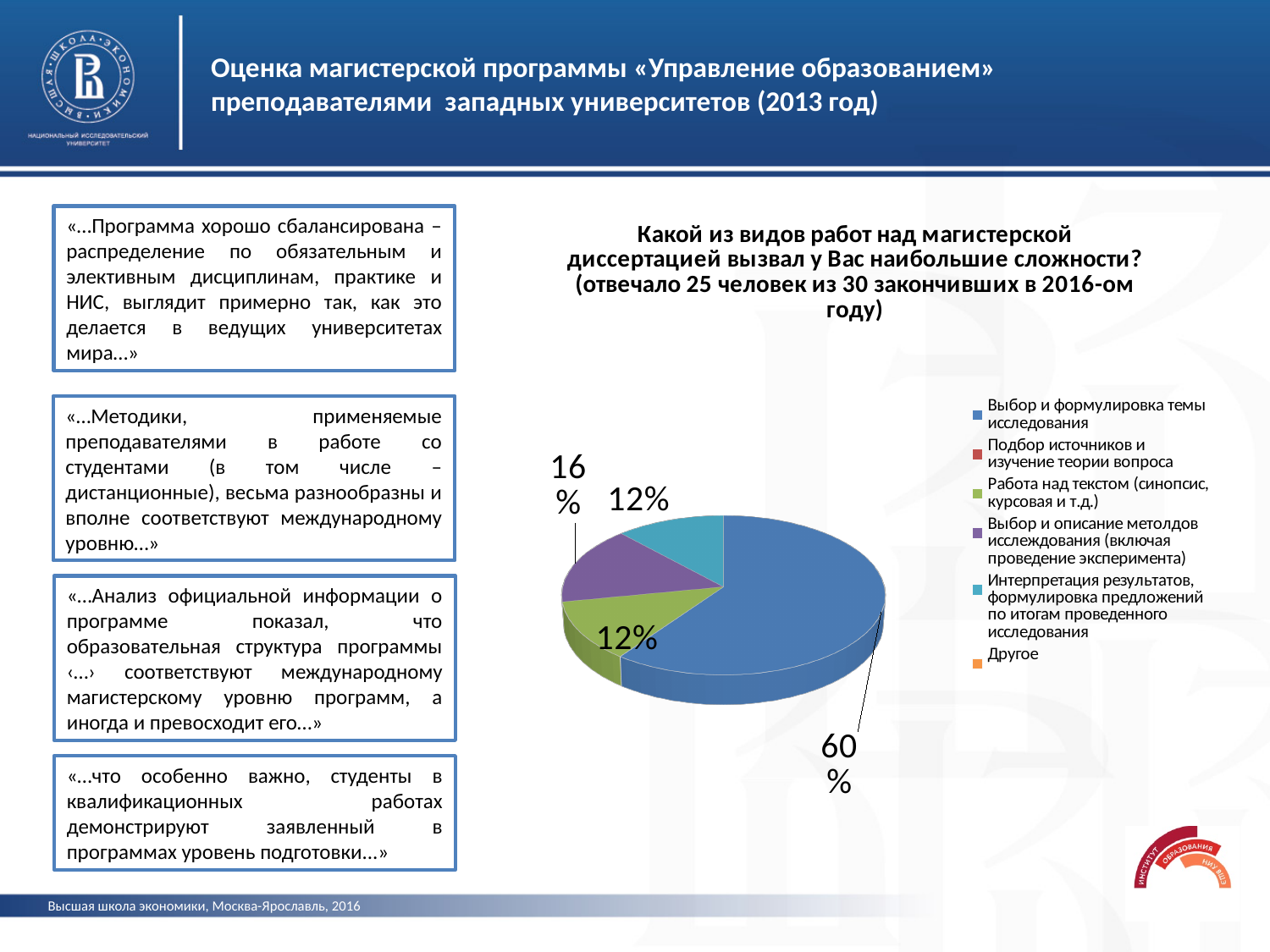
What percentage is shown for "Работа над текстом (синопсис, курсовая и т.д.)"? 12% Which category has the largest share of the pie? Выбор и формулировка темы исследования How many percentage points larger is the share for "Выбор и формулировка темы исследования" than the share for "Выбор и описание методов исследования"? 44 What colour is the slice representing "Выбор и формулировка темы исследования"? blue What percentage is shown for "Выбор и описание методов исследования (включая проведение эксперимента)"? 16% How many entries does the chart legend list? 6 What kind of chart is shown on the slide? pie chart What percentage of respondents chose "Выбор и формулировка темы исследования" as the most difficult type of work? 60% How many slices of the pie are labelled with a percentage? 4 What percentage is shown for "Интерпретация результатов, формулировка предложений по итогам проведенного исследования"? 12% Which share is larger: "Выбор и описание методов исследования" or "Интерпретация результатов"? Выбор и описание методов исследования According to the chart title, how many people answered the question? 25